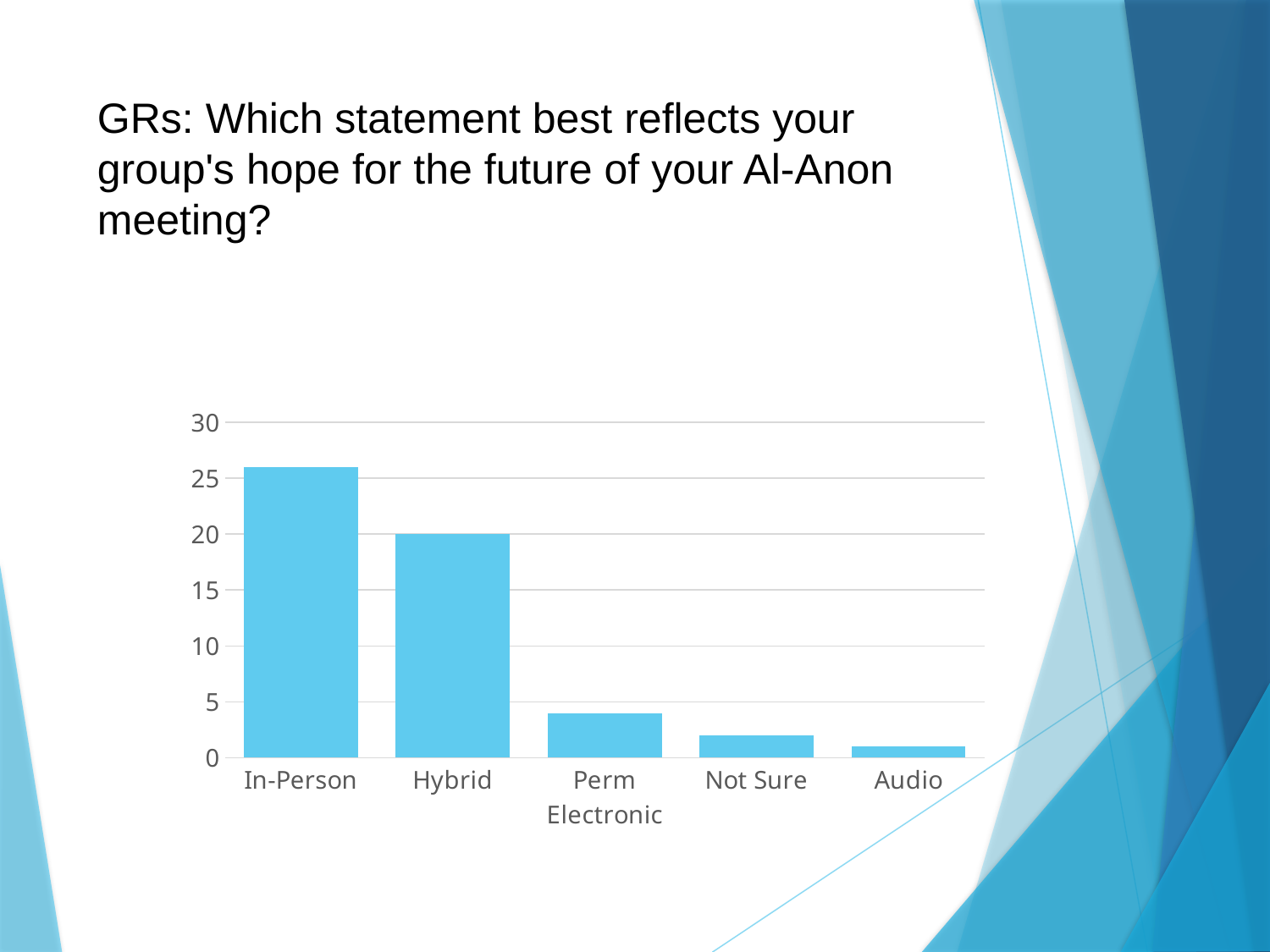
Which is larger, the value for Hybrid or the value for Perm Electronic? Hybrid What kind of chart is shown on the slide? Bar chart Which category has the lowest bar? Audio Is the value for Perm Electronic greater or less than 5? less Is the value for In-Person greater or less than 30? less Which is larger, the value for Not Sure or the value for Audio? Not Sure Is the value for In-Person greater or less than 25? greater How many categories are shown on the x axis? 5 What is the highest value shown on the vertical axis? 30 What is the value for Hybrid? 20 Which category has the highest bar? In-Person Do the values rise or fall from left to right along the x axis? Fall